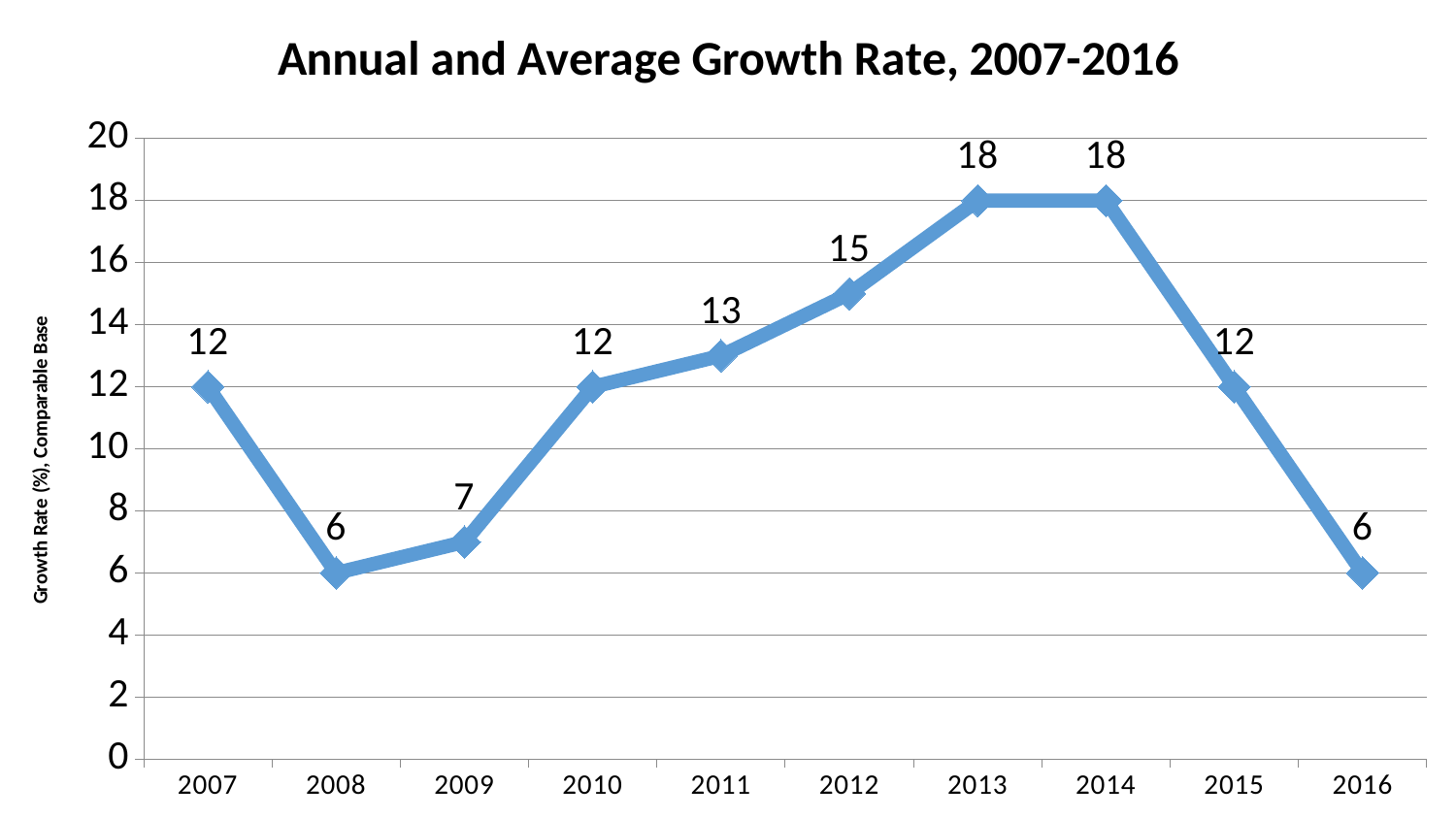
What is the title of the chart? Annual and Average Growth Rate, 2007-2016 How many years are plotted on the chart? 10 Does the growth rate rise or fall from 2014 to 2016? Fall What kind of chart is shown on the slide? Line chart What is the growth rate for 2012? 15 What is the highest growth rate shown on the chart? 18 Which year has a higher growth rate, 2011 or 2015? 2011 What is the growth rate for 2015? 12 What is the growth rate for 2009? 7 Is the value for 2014 greater or less than 16? greater Which year has the lowest growth rate? 2008 and 2016 What is the difference between the growth rate in 2013 and the growth rate in 2008? 12